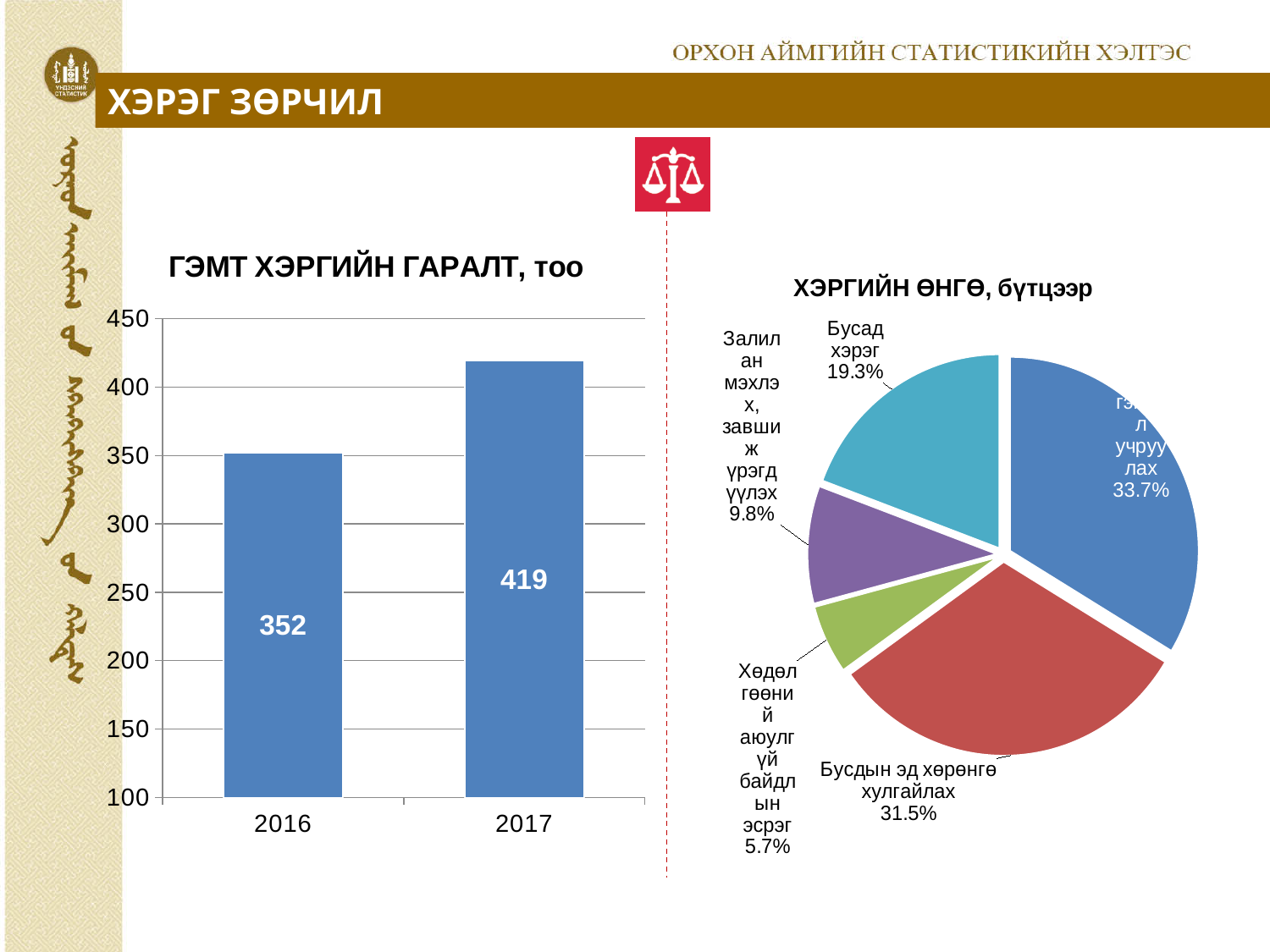
What kind of chart is 'ГЭМТ ХЭРГИЙН ГАРАЛТ, тоо'? bar chart In the pie chart 'ХЭРГИЙН ӨНГӨ, бүтцээр', what share does 'Залилан мэхлэх, завшиж үрэгдүүлэх' have? 9.8% In the bar chart 'ГЭМТ ХЭРГИЙН ГАРАЛТ, тоо', what is the difference between the 2017 and 2016 values? 67 In the pie chart 'ХЭРГИЙН ӨНГӨ, бүтцээр', what share does 'Бусад хэрэг' have? 19.3% In the pie chart 'ХЭРГИЙН ӨНГӨ, бүтцээр', which slice is larger, 'Бусад хэрэг' or 'Хөдөлгөөний аюулгүй байдлын эсрэг'? Бусад хэрэг In the pie chart 'ХЭРГИЙН ӨНГӨ, бүтцээр', what share does 'Бусдын эд хөрөнгө хулгайлах' have? 31.5% In the bar chart 'ГЭМТ ХЭРГИЙН ГАРАЛТ, тоо', how many bars are shown? 2 In the bar chart 'ГЭМТ ХЭРГИЙН ГАРАЛТ, тоо', which year has the higher value, 2016 or 2017? 2017 In the bar chart 'ГЭМТ ХЭРГИЙН ГАРАЛТ, тоо', do the values rise or fall from 2016 to 2017? rise In the bar chart 'ГЭМТ ХЭРГИЙН ГАРАЛТ, тоо', what is the value for 2017? 419 In the bar chart 'ГЭМТ ХЭРГИЙН ГАРАЛТ, тоо', what is the value for 2016? 352